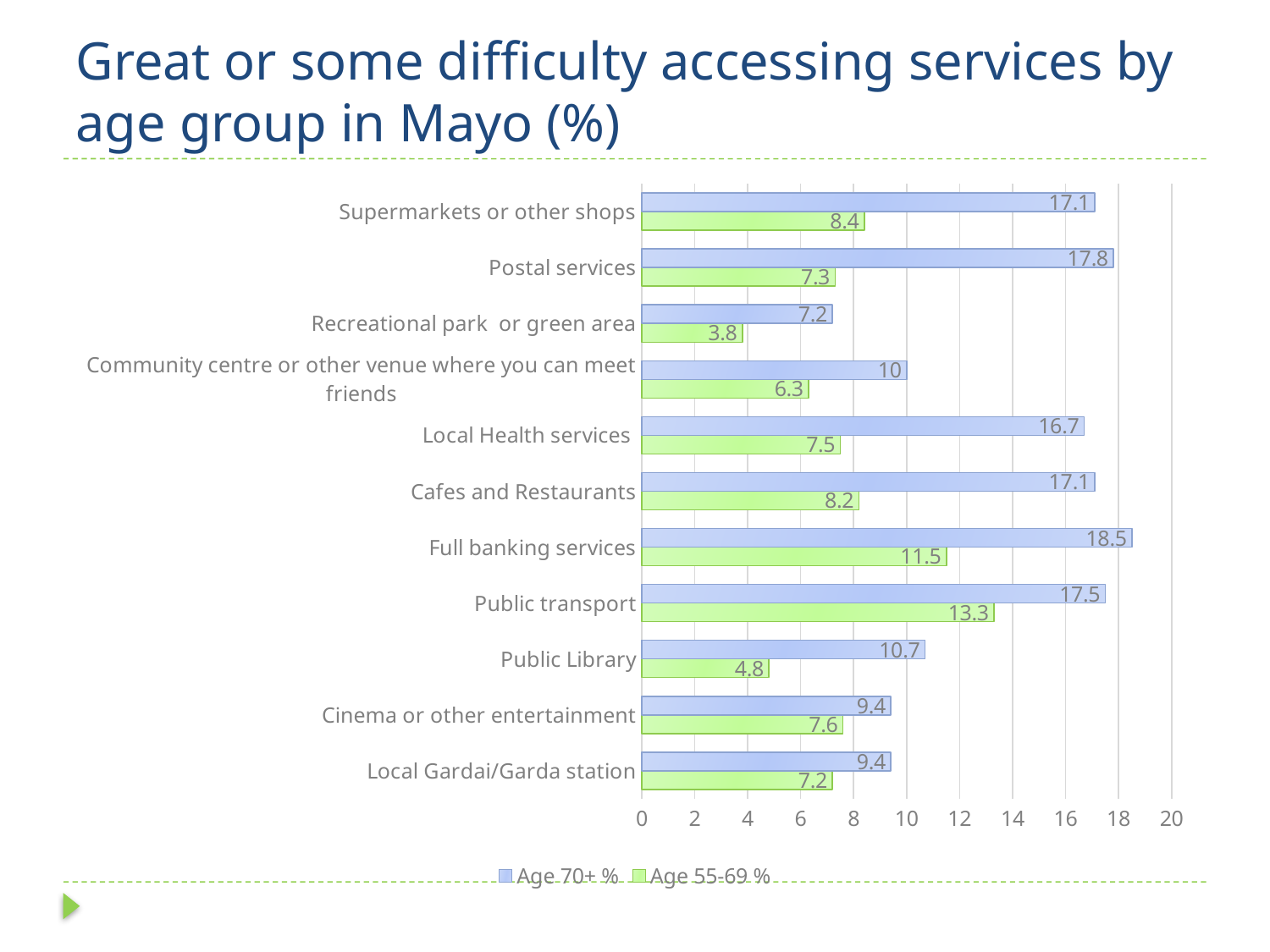
What is the value for Age 55-69 % for Public transport? 13.3 What is the difference between the Age 70+ % and Age 55-69 % values for Postal services? 10.5 Which colour represents the Age 55-69 % series? Green Which category has the highest value for Age 70+ %? Full banking services Which is larger for Public Library: the Age 70+ % value or the Age 55-69 % value? Age 70+ % What kind of chart is shown on the slide? Bar chart Which category has the lowest value for Age 55-69 %? Recreational park or green area How many series does the legend list? 2 What is the title of the chart? Great or some difficulty accessing services by age group in Mayo (%) What is the value for Age 55-69 % for Recreational park or green area? 3.8 How many service categories are shown in the chart? 11 What is the value for Age 70+ % for Full banking services? 18.5